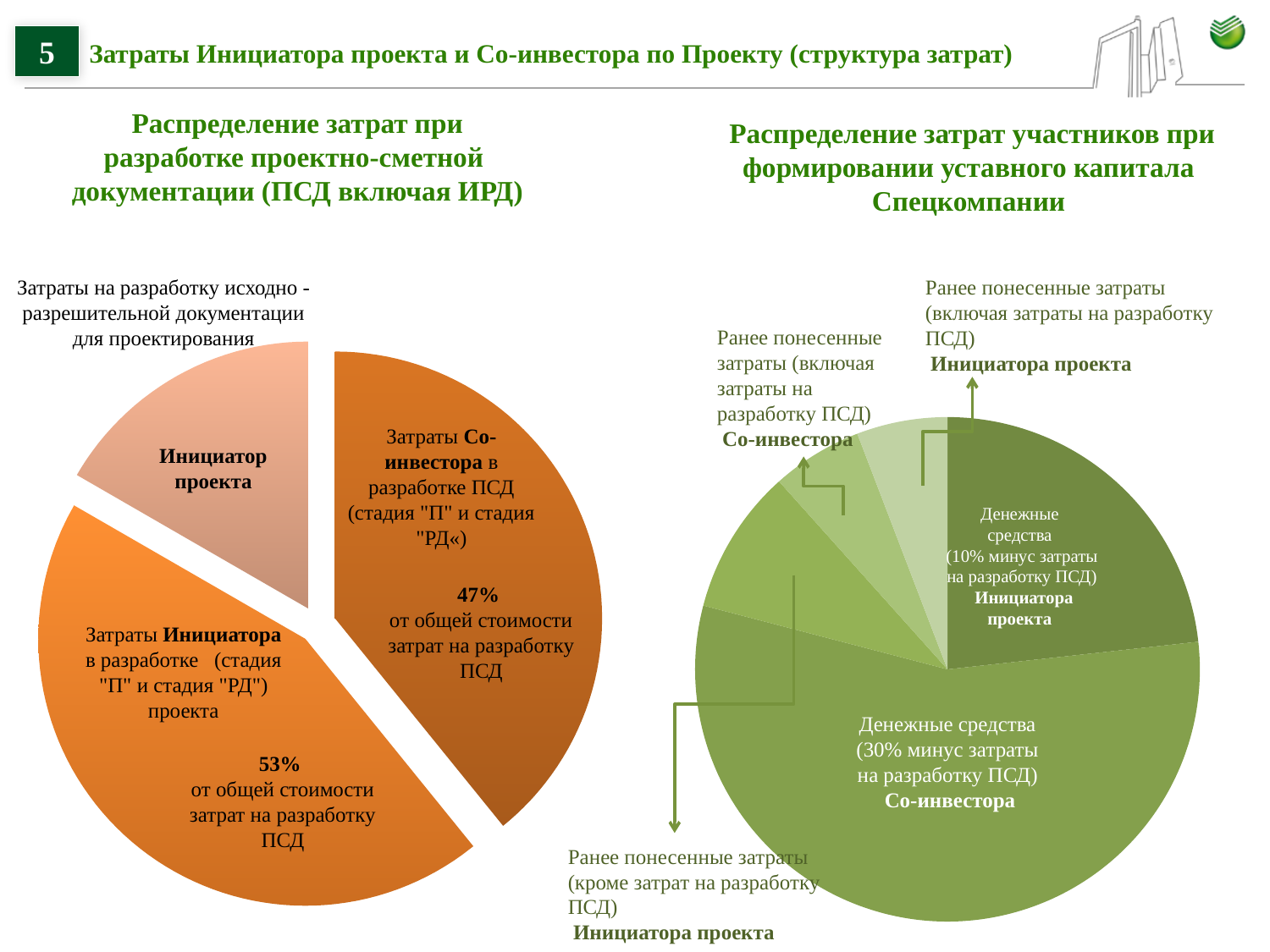
In the right pie chart, which slice is the largest? Денежные средства (30% минус затраты на разработку ПСД) Со-инвестора In the left pie chart, what is the difference between the Инициатор's 53% and the Со-инвестор's 47%? 6 percentage points In the left pie chart, what percentage of the total PSD development cost is labelled for the Инициатор's costs in PSD development (stages П and РД)? 53% In the left pie chart, what percentage of the total PSD development cost is labelled for the Со-инвестор's costs? 47% What is the title of the right pie chart? Распределение затрат участников при формировании уставного капитала Спецкомпании What type of chart is the left chart, 'Распределение затрат при разработке проектно-сметной документации (ПСД включая ИРД)'? Pie chart What is the title of the left pie chart? Распределение затрат при разработке проектно-сметной документации (ПСД включая ИРД) What type of chart is the right chart, 'Распределение затрат участников при формировании уставного капитала Спецкомпании'? Pie chart In the left pie chart, which is larger: the Инициатор's PSD development costs or the Со-инвестор's PSD development costs? Инициатор's costs (53%) How many slices does the left pie chart (ПСД включая ИРД) have? 3 In the left pie chart, which slice is the largest? Затраты Инициатора в разработке ПСД (53%) How many slices does the right pie chart (уставный капитал Спецкомпании) have? 5